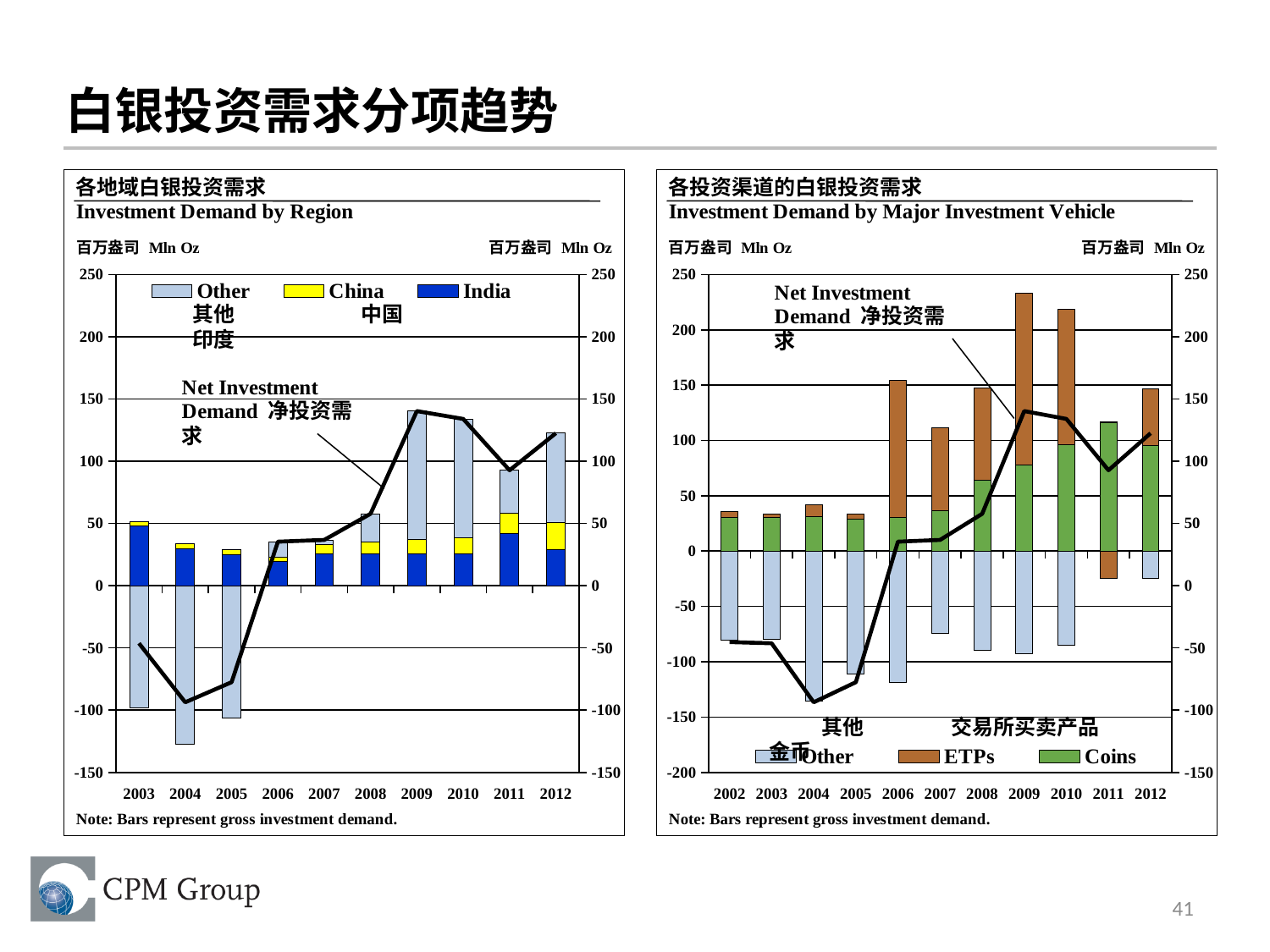
In the 'Investment Demand by Major Investment Vehicle' chart, is the top of the positive stacked bar for 2009 greater or less than 200? greater How many years are shown on the x axis of the 'Investment Demand by Region' chart? 10 How many years are shown on the x axis of the 'Investment Demand by Major Investment Vehicle' chart? 11 In the 'Investment Demand by Region' chart, is the Net Investment Demand line for 2004 greater or less than -50? less Which series are listed in the legend of the 'Investment Demand by Major Investment Vehicle' chart? Other, ETPs, Coins What type of chart is the 'Investment Demand by Region' chart on the left? Stacked bar chart with a line In the 'Investment Demand by Region' chart, which year has the lowest Net Investment Demand? 2004 In the 'Investment Demand by Region' chart, is the Net Investment Demand line for 2009 greater or less than 100? greater In the 'Investment Demand by Region' chart, does the Net Investment Demand line rise or fall from 2005 to 2009? rise In the 'Investment Demand by Major Investment Vehicle' chart, which year has the lowest Net Investment Demand? 2004 How many series does the legend of the 'Investment Demand by Region' chart list for the bars? 3 In the 'Investment Demand by Major Investment Vehicle' chart, which year has the tallest positive stacked bar? 2009